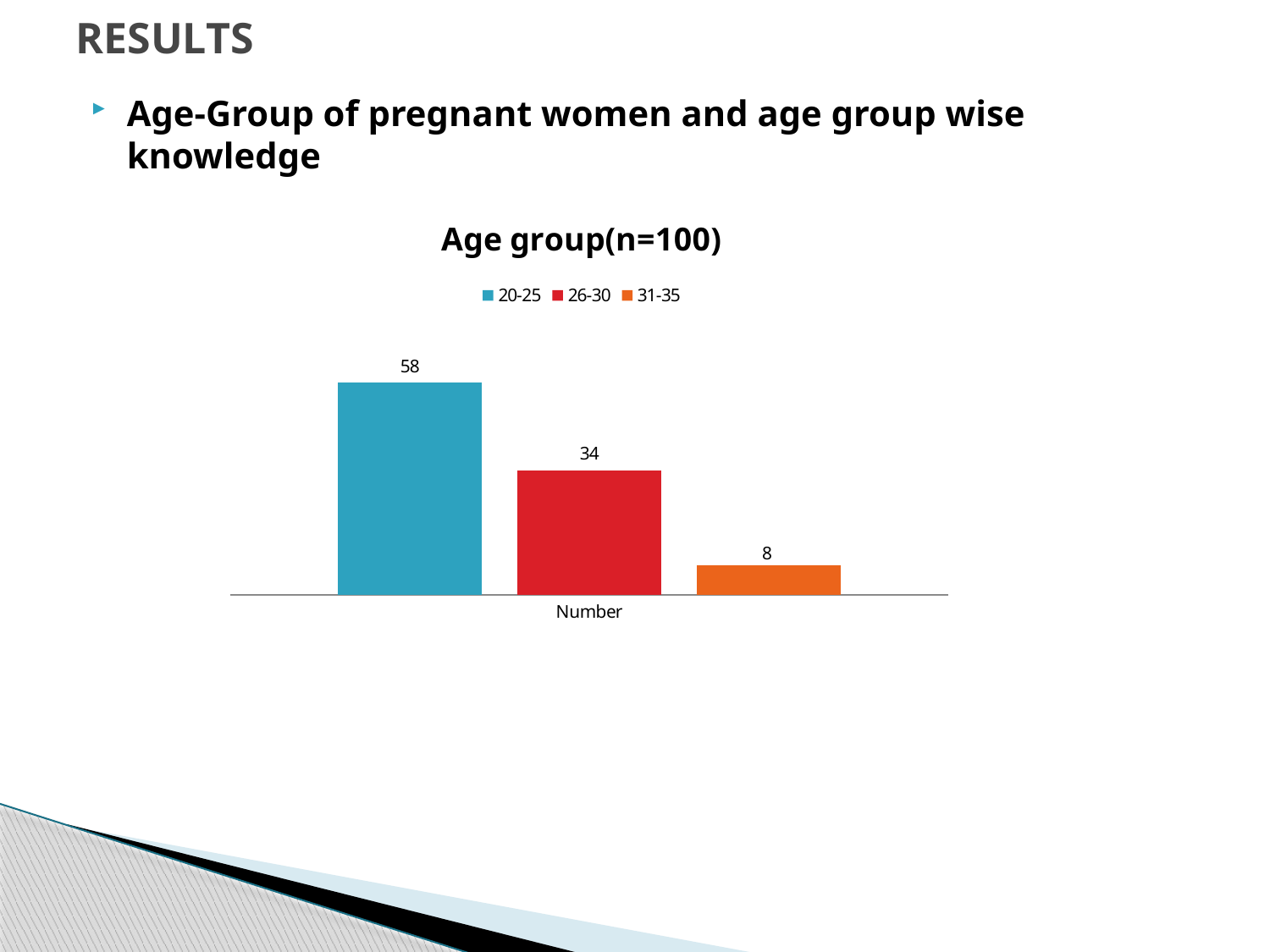
What kind of chart is shown on the slide? Bar chart What is the difference between the values for the 20-25 and 26-30 age groups? 24 Which age group has the highest value? 20-25 How many series does the legend list? 3 Which age group has the lowest value? 31-35 What is the difference between the values for the 26-30 and 31-35 age groups? 26 Which is larger, the value for 26-30 or the value for 31-35? 26-30 What is the label on the x axis of the chart? Number What is the value for the 20-25 age group? 58 What is the value for the 31-35 age group? 8 What is the title of the chart? Age group(n=100) What is the value for the 26-30 age group? 34